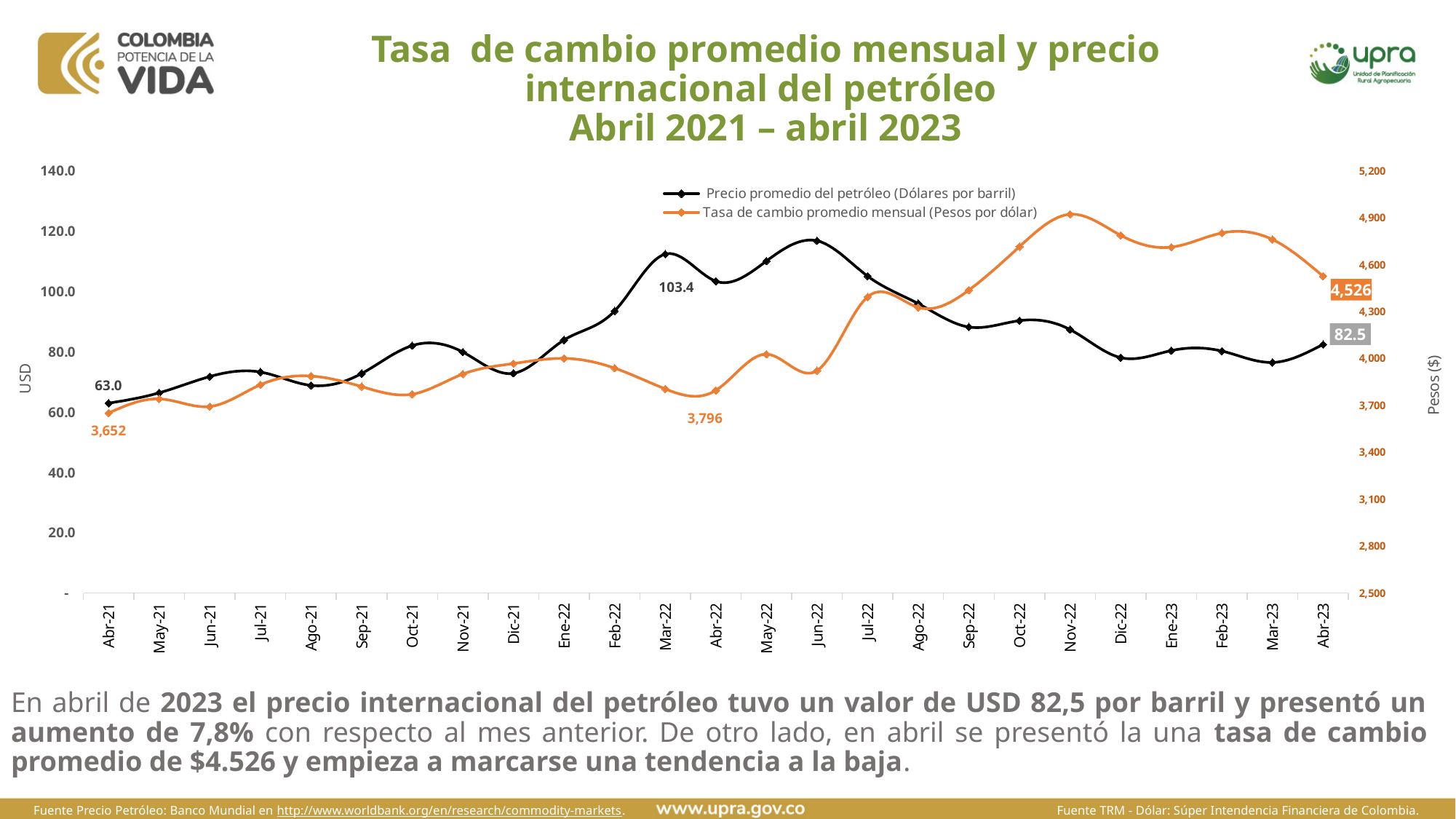
What kind of chart is shown on the slide? line chart What was the average oil price (Dólares por barril) in Abr-22? 103.4 How many series does the legend list? 2 Is the average oil price in Jun-22 greater or less than 100.0? greater What was the average oil price (Dólares por barril) in Abr-21? 63.0 What was the average monthly exchange rate (Pesos por dólar) in Abr-21? 3,652 In which month did the average monthly exchange rate (Pesos por dólar) reach its highest value? Nov-22 What was the average oil price (Dólares por barril) in Abr-23? 82.5 What was the average monthly exchange rate (Pesos por dólar) in Abr-23? 4,526 What was the average monthly exchange rate (Pesos por dólar) in Abr-22? 3,796 How many months are plotted on the x axis? 25 By how much did the average monthly exchange rate increase from Abr-21 to Abr-23? 874